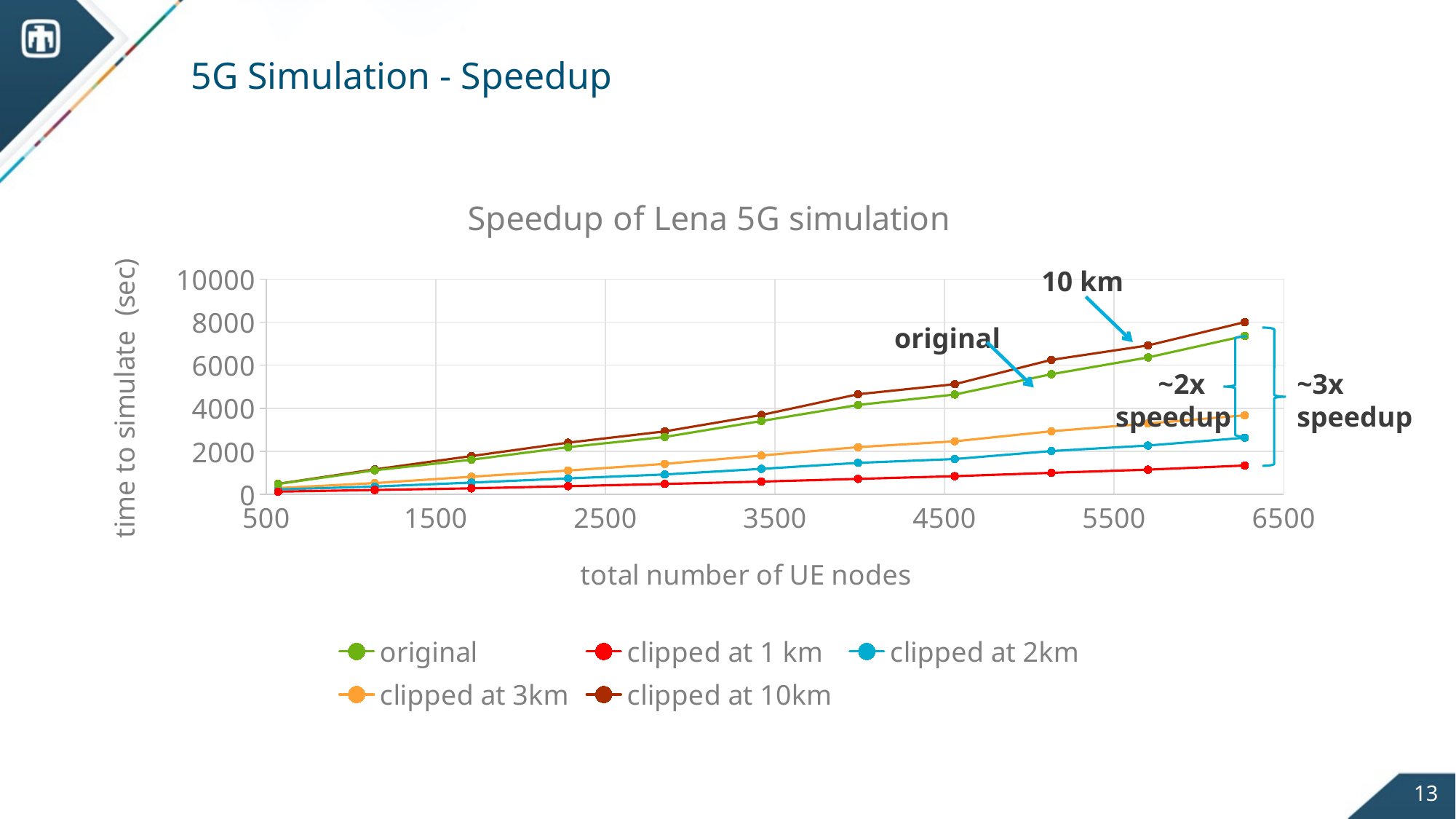
What kind of chart is shown on the slide? line chart Which series has the highest time to simulate at the largest number of UE nodes? clipped at 10km Which series has the lowest time to simulate across the chart? clipped at 1 km Is the value for the clipped at 3km series at the rightmost point greater or less than 4000? less Is the value for the clipped at 10km series at the rightmost point greater or less than 6000? greater How many data points are plotted for each series? 11 At the rightmost point, which is larger: the value for clipped at 3km or the value for clipped at 2km? clipped at 3km Does the time to simulate for the original series rise or fall as the total number of UE nodes increases? rise What is the label of the y axis? time to simulate (sec) Is the value for the clipped at 1 km series at the rightmost point greater or less than 2000? less What is the title of the chart? Speedup of Lena 5G simulation How many series does the legend list? 5